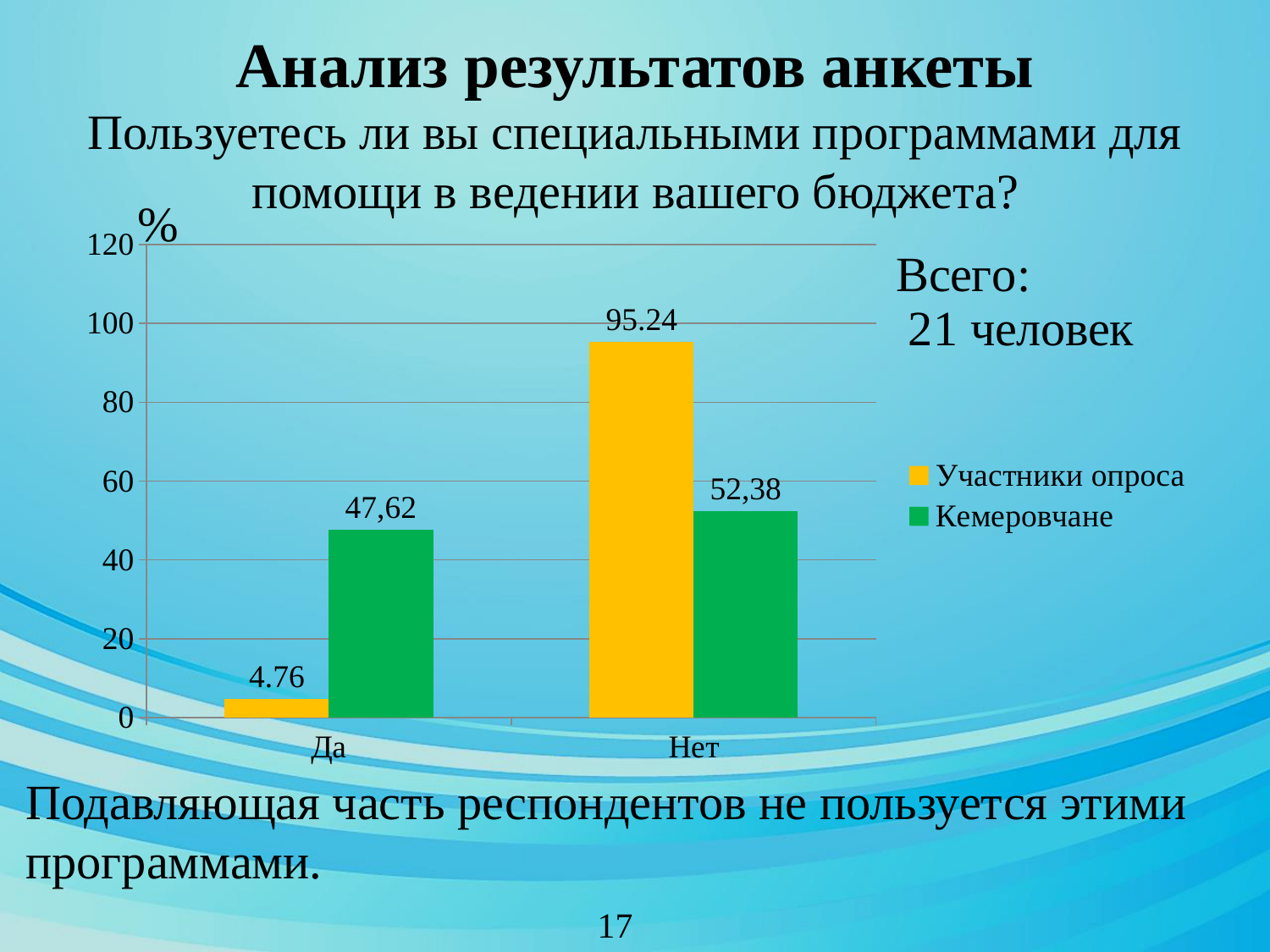
What kind of chart is shown on the slide? Bar chart What is the difference between the Кемеровчане values for Нет and Да? 4,76 In the Да category, which series has the larger value: Участники опроса or Кемеровчане? Кемеровчане What is the difference between the Участники опроса values for Нет and Да? 90.48 How many series does the legend list? 2 What is the value for Кемеровчане in the Да category? 47,62 What is the value for Участники опроса in the Да category? 4.76 What is the value for Участники опроса in the Нет category? 95.24 Which category has the lowest value for Кемеровчане? Да What is the value for Кемеровчане in the Нет category? 52,38 Which category has the highest value for Участники опроса? Нет How many categories are shown on the x axis? 2